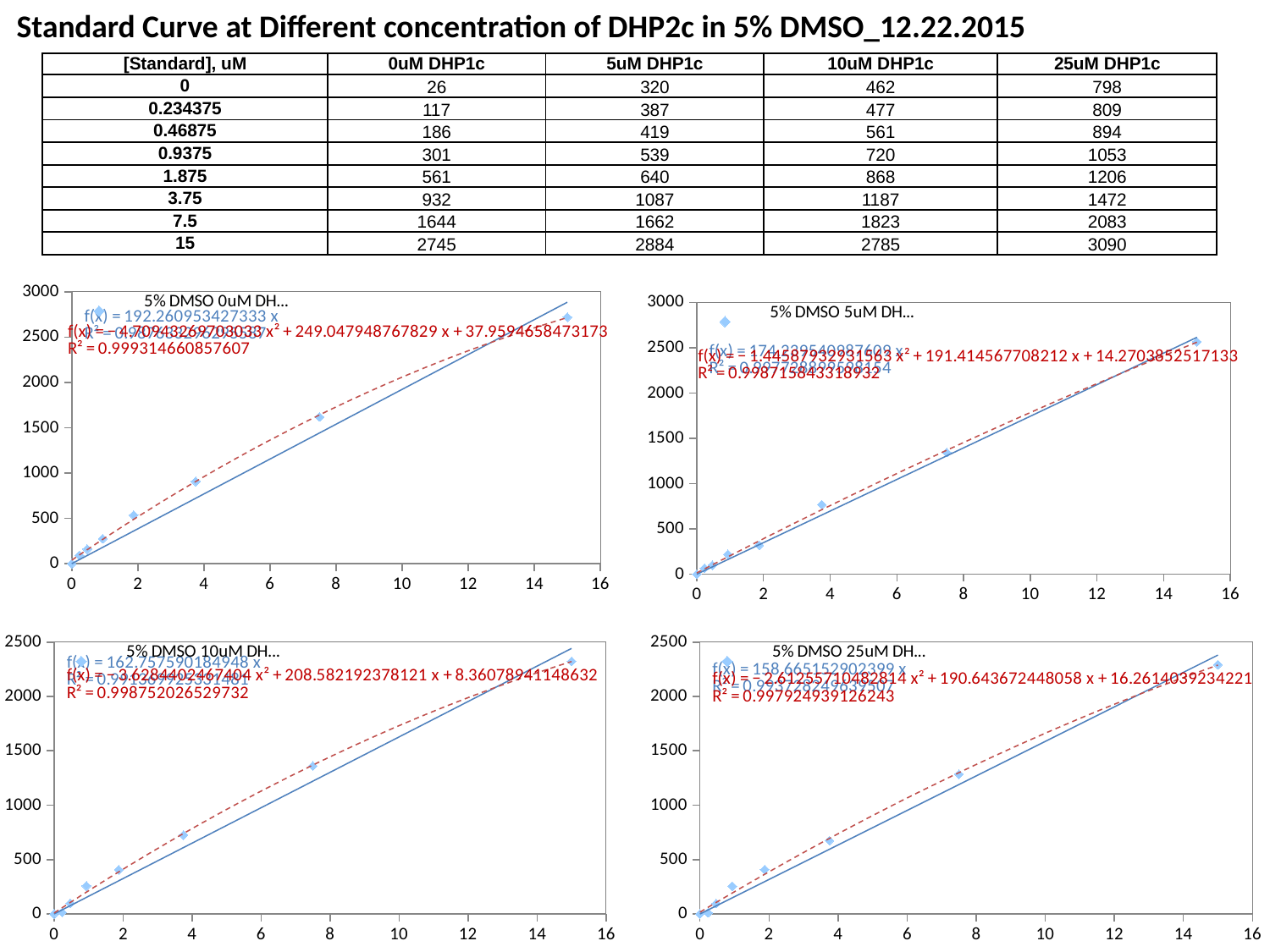
What R² value is shown in red for the polynomial fit in the '5% DMSO 25uM DH...' chart? 0.997924939126243 In the '5% DMSO 5uM DH...' chart, is the value of the point at x = 7.5 greater or less than 1500? less In the '5% DMSO 25uM DH...' chart, is the value of the point at x = 7.5 greater or less than 1000? greater How many charts are shown on the slide? 4 What kind of chart is the '5% DMSO 0uM DH...' chart? Scatter chart In the '5% DMSO 0uM DH...' chart, is the value of the point at x = 15 greater or less than 2500? greater How many data points are plotted in the '5% DMSO 10uM DH...' chart? 8 In the '5% DMSO 0uM DH...' chart, which plotted point has the highest value? The point at x = 15 What is the maximum value shown on the y axis of the '5% DMSO 10uM DH...' chart? 2500 What R² value is shown in red for the polynomial fit in the '5% DMSO 0uM DH...' chart? 0.999314660857607 In the '5% DMSO 0uM DH...' chart, do the plotted values rise or fall as x increases? Rise